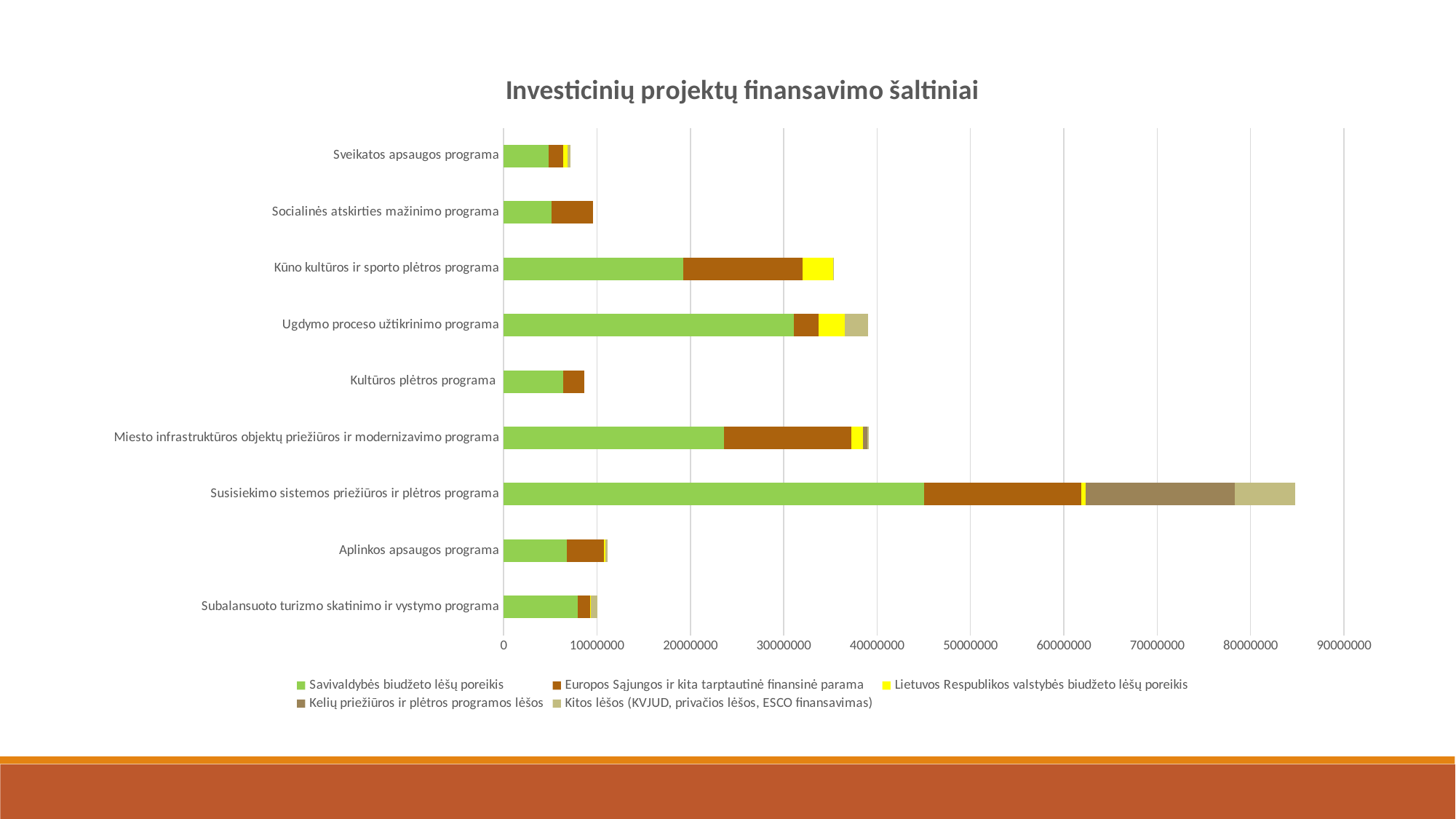
Is the total value for Kūno kultūros ir sporto plėtros programa greater or less than 40000000? less Is the total value for Sveikatos apsaugos programa greater or less than 10000000? less Which has the larger total bar: Susisiekimo sistemos priežiūros ir plėtros programa or Miesto infrastruktūros objektų priežiūros ir modernizavimo programa? Susisiekimo sistemos priežiūros ir plėtros programa Which series is shown in yellow in the legend? Lietuvos Respublikos valstybės biudžeto lėšų poreikis Which has the larger Savivaldybės biudžeto lėšų poreikis segment: Ugdymo proceso užtikrinimo programa or Kūno kultūros ir sporto plėtros programa? Ugdymo proceso užtikrinimo programa How many programmes (categories) are plotted on the chart? 9 What kind of chart is shown on the slide? Stacked bar chart Which programme has the largest total bar? Susisiekimo sistemos priežiūros ir plėtros programa Is the Savivaldybės biudžeto lėšų poreikis value for Susisiekimo sistemos priežiūros ir plėtros programa greater or less than 40000000? greater What is the title of the chart? Investicinių projektų finansavimo šaltiniai How many series does the legend list? 5